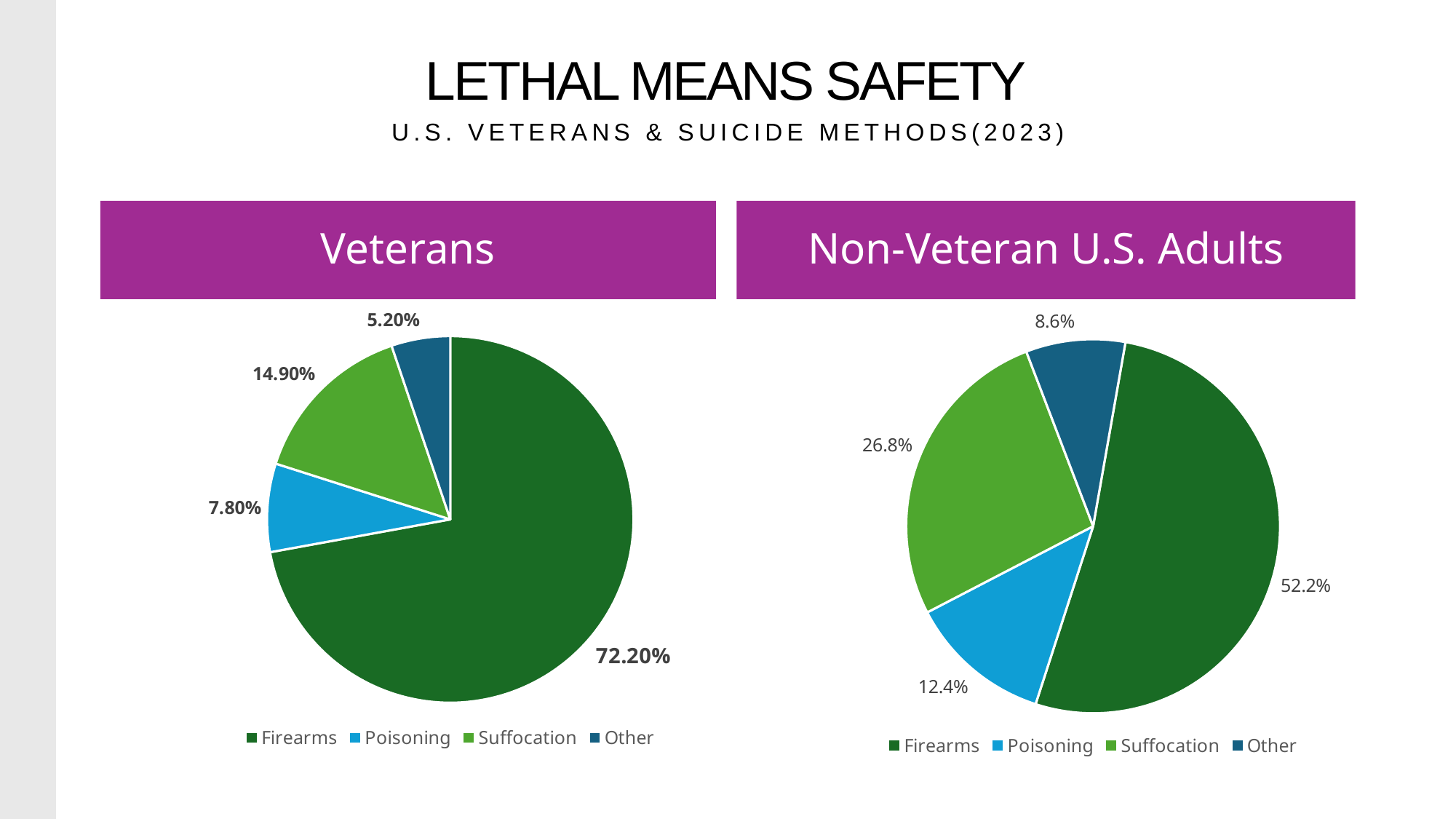
In the Non-Veteran U.S. Adults pie chart, which category has the smallest slice? Other In the Non-Veteran U.S. Adults pie chart, what is the difference between the Firearms and Suffocation percentages? 25.4% In the Veterans pie chart, what percentage is shown for Firearms? 72.20% What type of chart is used for the Veterans data? Pie chart In the Veterans pie chart, which category has the smallest slice? Other How many slices does the Non-Veteran U.S. Adults pie chart have? 4 In the Veterans pie chart, which is larger: Suffocation or Poisoning? Suffocation In the Non-Veteran U.S. Adults pie chart, what percentage is shown for Other? 8.6% In the Veterans pie chart, what percentage is shown for Poisoning? 7.80% In the Veterans pie chart, which category has the largest slice? Firearms In the Non-Veteran U.S. Adults pie chart, what percentage is shown for Suffocation? 26.8% What are the four legend entries listed under the Veterans chart? Firearms, Poisoning, Suffocation, Other